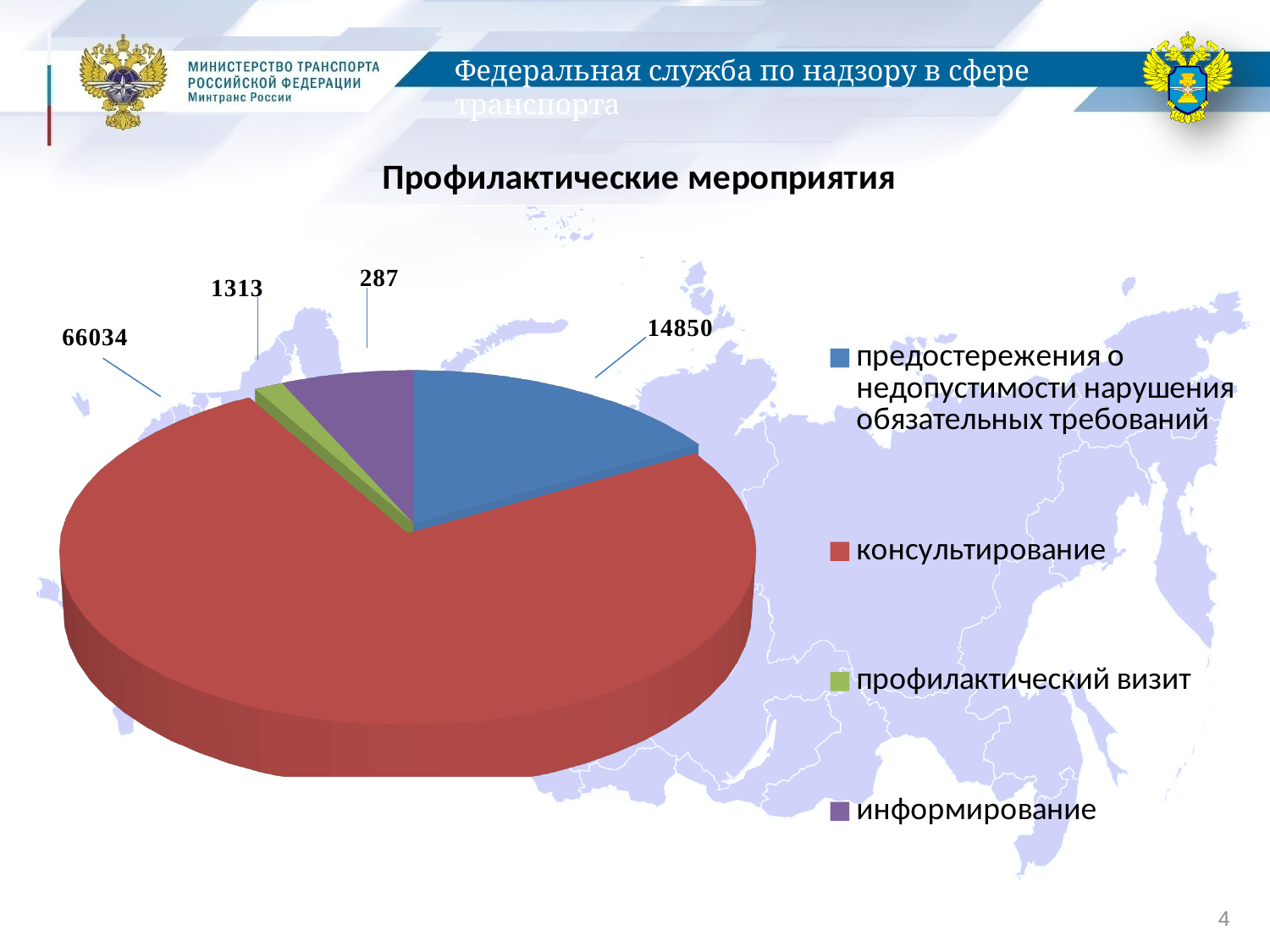
What is the value for предостережения о недопустимости нарушения обязательных требований? 14850 Which category has the largest slice of the pie? консультирование Which is larger: консультирование or предостережения о недопустимости нарушения обязательных требований? консультирование What kind of chart is shown on the slide? Pie chart What colour is the slice for консультирование? Red What is the difference between the values for консультирование and предостережения о недопустимости нарушения обязательных требований? 51184 How many entries does the legend list? 4 What is the total of all four values shown on the pie chart? 82484 How many categories (slices) does the pie chart have? 4 What is the value for консультирование? 66034 What is the title of the chart? Профилактические мероприятия